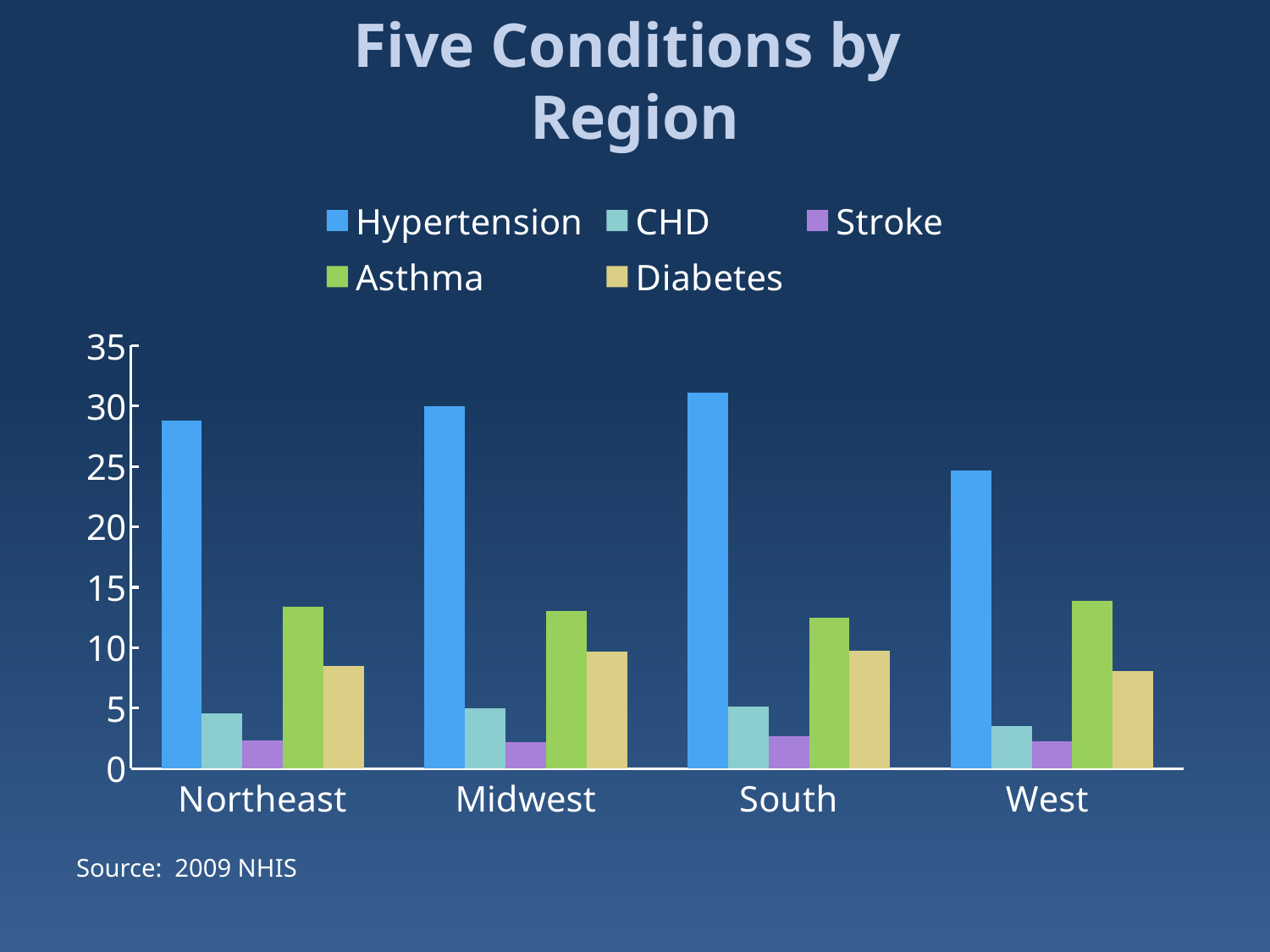
Which region has the lowest Hypertension value? West In the Midwest, which is larger, CHD or Stroke? CHD Which condition has the highest value in the South? Hypertension How many regions are shown on the x axis? 4 Is the CHD value for West greater or less than 5? less What is the title of the chart? Five Conditions by Region Is the Hypertension value for Northeast greater or less than 30? less Is the Asthma value for Northeast greater or less than 10? greater How many series does the legend list? 5 In the Northeast, which is larger, Asthma or Diabetes? Asthma Which condition has the lowest value in the Midwest? Stroke What kind of chart is shown on the slide? bar chart